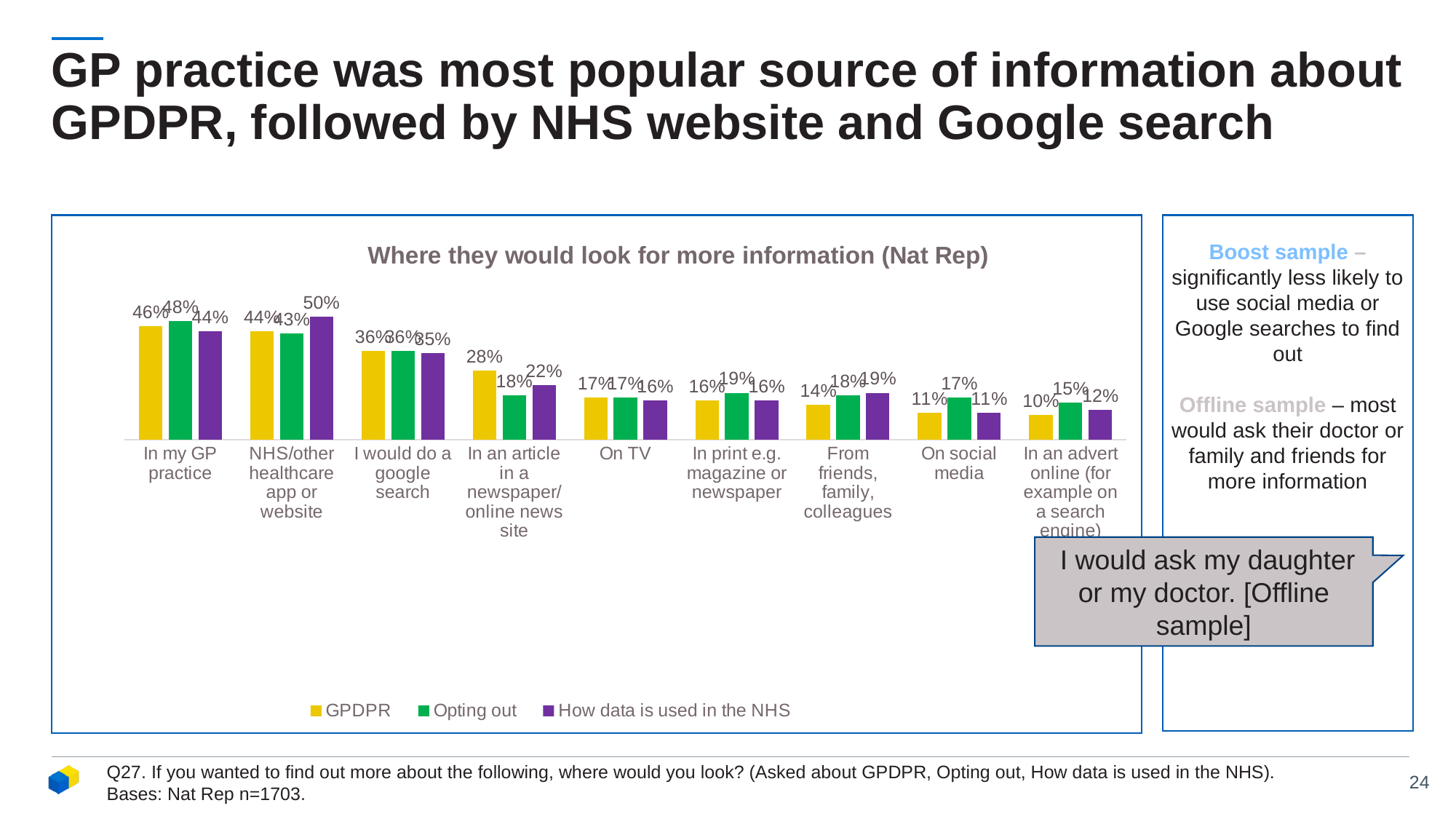
For 'From friends, family, colleagues', which is larger: the GPDPR value or the 'How data is used in the NHS' value? How data is used in the NHS What is the difference between the GPDPR and 'Opting out' values for 'In an article in a newspaper/online news site'? 10% Which category has the highest GPDPR value? In my GP practice What is the GPDPR value for 'In an article in a newspaper/online news site'? 28% Which colour represents the 'Opting out' series? green What is the 'Opting out' value for 'In an advert online (for example on a search engine)'? 15% What is the 'Opting out' value for 'On social media'? 17% How many series does the legend list? 3 What kind of chart is shown on the slide? bar chart How many categories are shown along the x axis? 9 What is the value for 'How data is used in the NHS' for 'NHS/other healthcare app or website'? 50% Which category has the lowest GPDPR value? In an advert online (for example on a search engine)